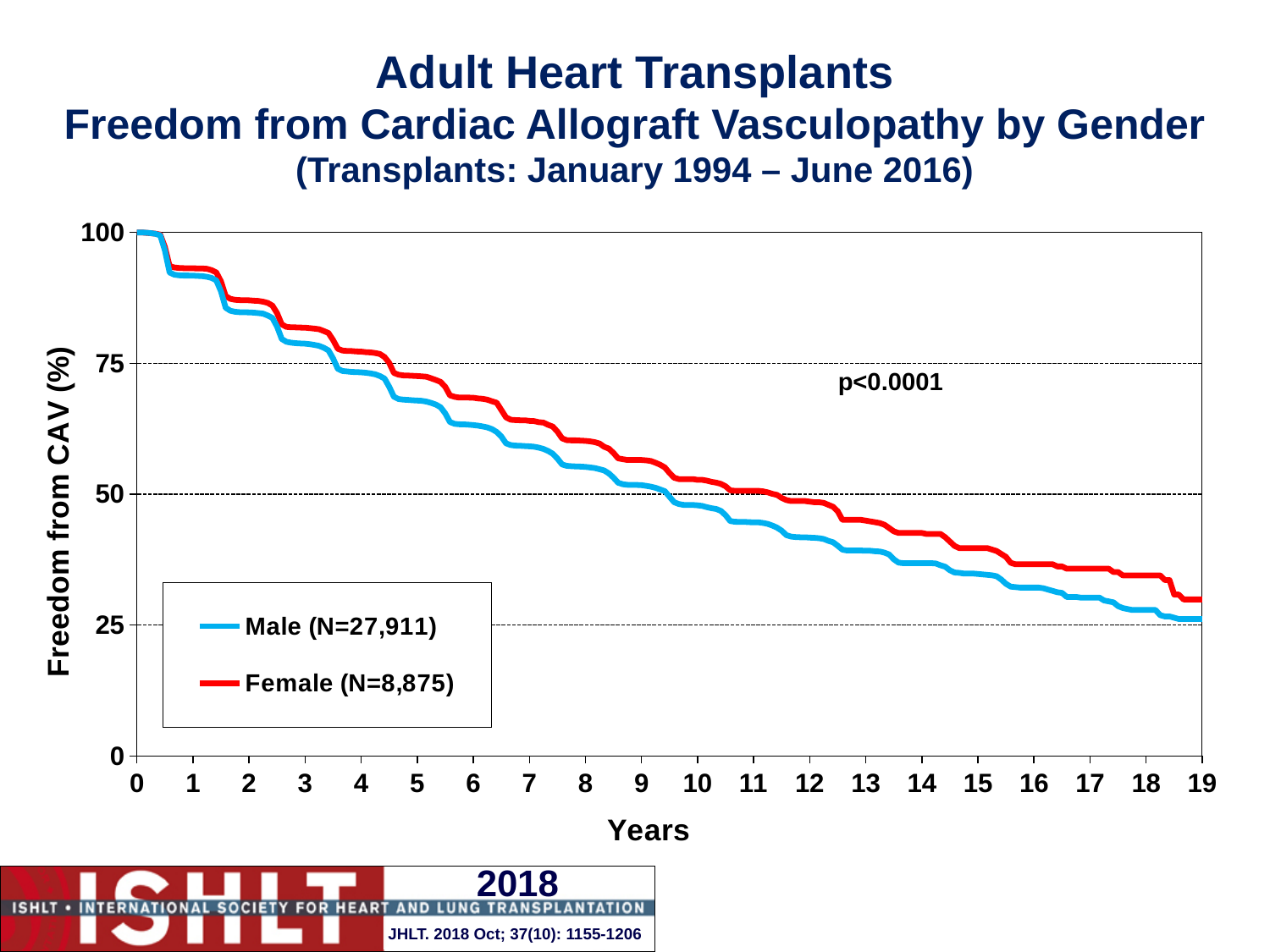
Is the value for Male at 15 years greater or less than 50? less What is the number of patients (N) given in the legend for the Male series? 27,911 Do the values for Female rise or fall as the years increase? fall What kind of chart is shown on the slide? line chart What p-value is printed on the chart? p<0.0001 Is the value for Male at 5 years greater or less than 50? greater Do the values for Male rise or fall as the years increase? fall At 19 years, which series has the lower freedom from CAV, Male or Female? Male Is the value for Female at 15 years greater or less than 50? less At 10 years, which series has the higher freedom from CAV, Male or Female? Female How many series does the legend list? 2